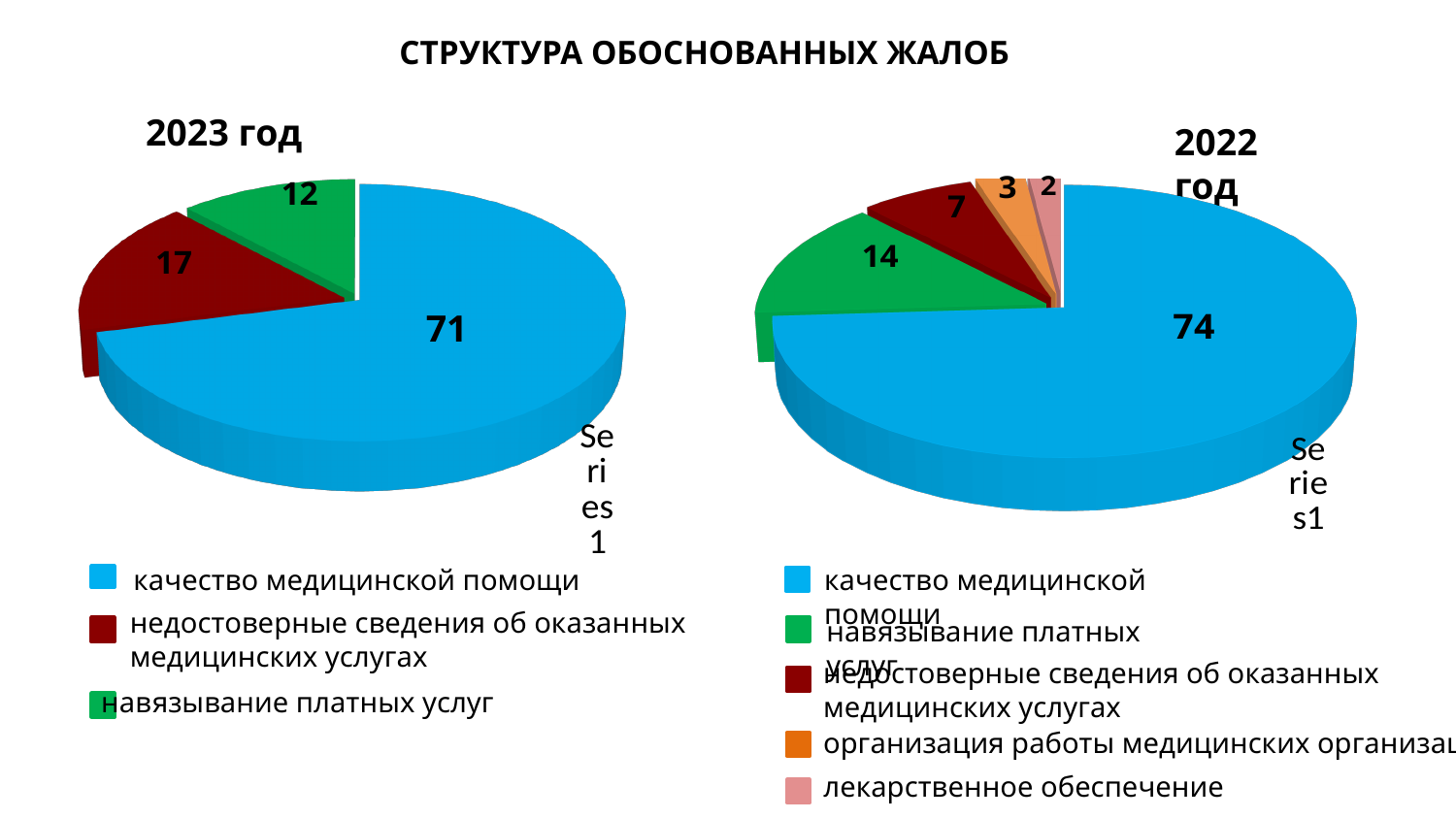
Which is larger: the value for качество медицинской помощи in the 2022 год chart or in the 2023 год chart? 2022 год What type of chart is used for the 2023 год data? pie chart In the 2022 год pie chart, what is the value for навязывание платных услуг? 14 In the 2023 год pie chart, which category has the largest value? качество медицинской помощи How many slices does the 2023 год pie chart have? 3 How many slices does the 2022 год pie chart have? 5 In the 2023 год pie chart, what is the difference between the values for недостоверные сведения об оказанных медицинских услугах and навязывание платных услуг? 5 In the 2022 год pie chart, which category has the smallest value? лекарственное обеспечение In the 2023 год pie chart, what is the value for качество медицинской помощи? 71 In the 2023 год pie chart, what is the value for недостоверные сведения об оказанных медицинских услугах? 17 In the 2022 год pie chart, what is the value for лекарственное обеспечение? 2 What is the title of the slide above the two charts? СТРУКТУРА ОБОСНОВАННЫХ ЖАЛОБ